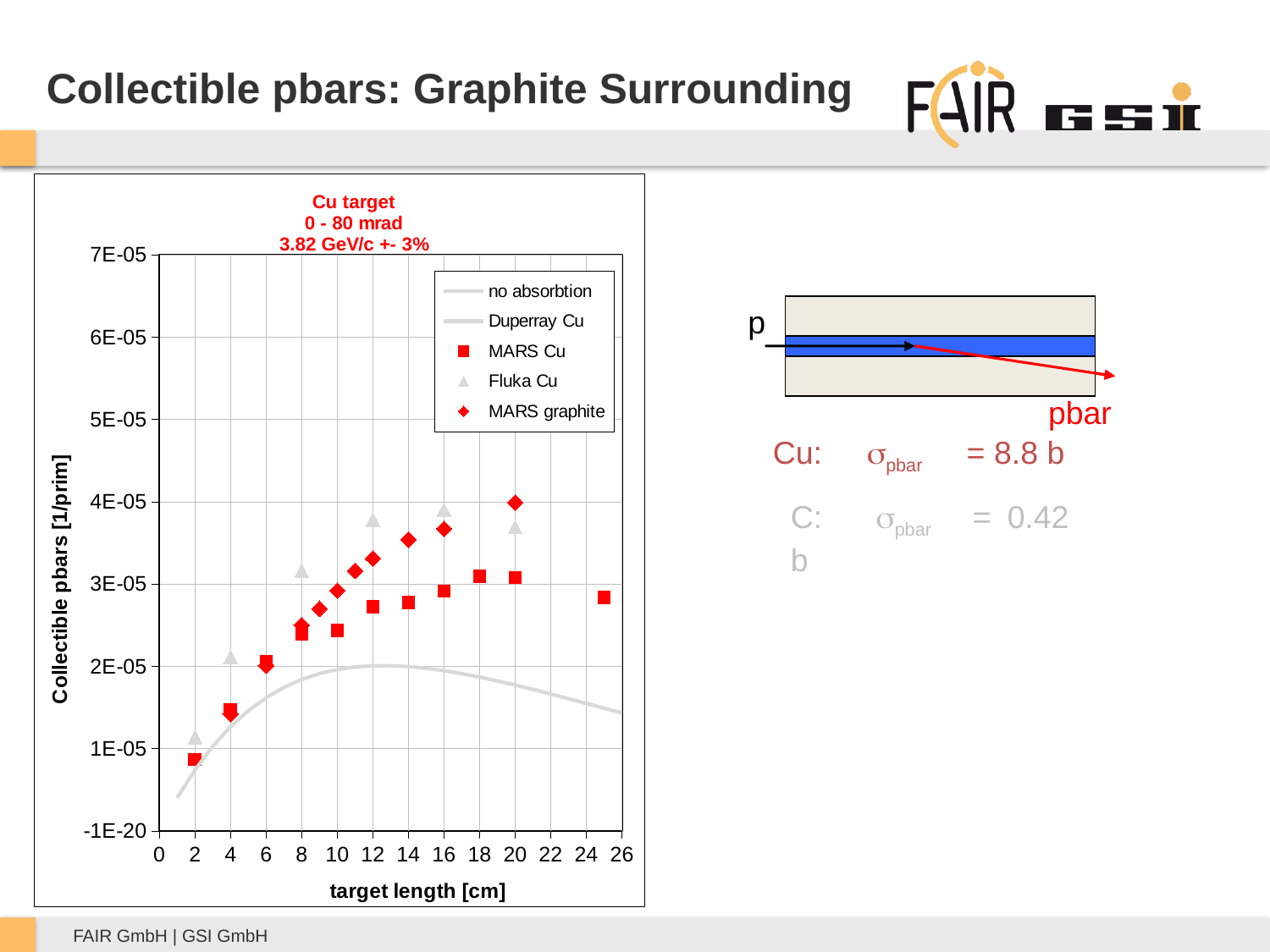
At a target length of 12 cm, which series has the larger value: Fluka Cu or MARS Cu? Fluka Cu At a target length of 20 cm, which series has the larger value: MARS graphite or MARS Cu? MARS graphite Is the MARS Cu value at a target length of 2 cm greater or less than 1E-05? less Is the MARS Cu value at a target length of 25 cm greater or less than 2E-05? greater How many series does the chart legend list? 5 Is the Fluka Cu value at a target length of 12 cm greater or less than 3E-05? greater Do the MARS graphite values rise or fall as the target length increases? rise What kind of chart is shown on the slide? scatter chart What is the label of the x axis of the chart? target length [cm] What is the label of the y axis of the chart? Collectible pbars [1/prim]